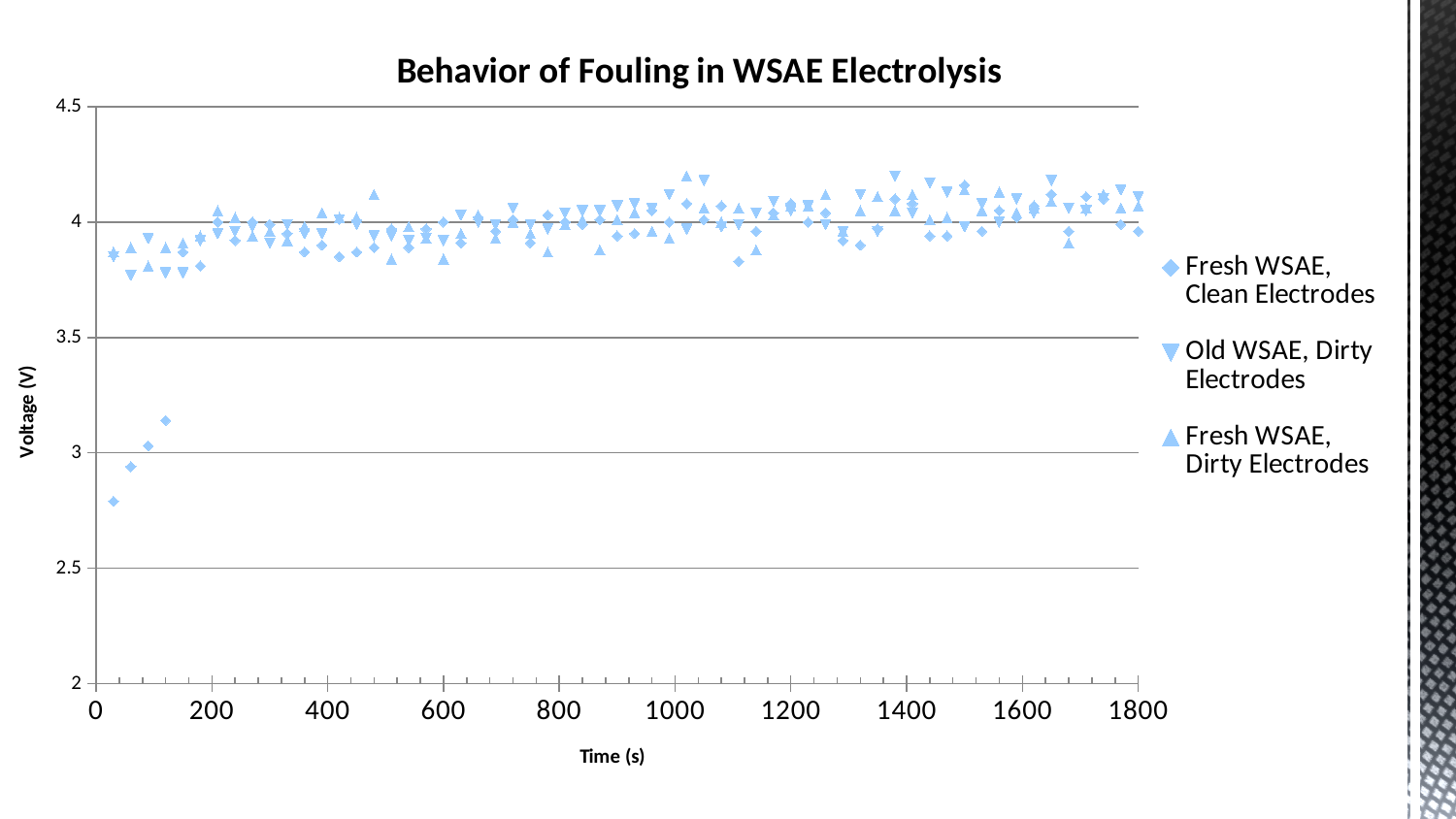
What is the label of the vertical axis? Voltage (V) How many series does the legend list? 3 What is the maximum value shown on the vertical axis? 4.5 Do the Fresh WSAE, Clean Electrodes values rise or fall over the first 200 seconds? rise Which series is represented by the downward-pointing triangle marker in the legend? Old WSAE, Dirty Electrodes Which series has the lowest plotted voltage value on the chart? Fresh WSAE, Clean Electrodes What kind of chart is shown on the slide? scatter chart What is the title of the chart? Behavior of Fouling in WSAE Electrolysis Is the earliest Fresh WSAE, Clean Electrodes point (near 30 s) greater or less than 3 V? less What is the maximum value shown on the horizontal axis? 1800 What is the label of the horizontal axis? Time (s) Are the Fresh WSAE, Clean Electrodes points after 200 s greater or less than 3.5 V? greater